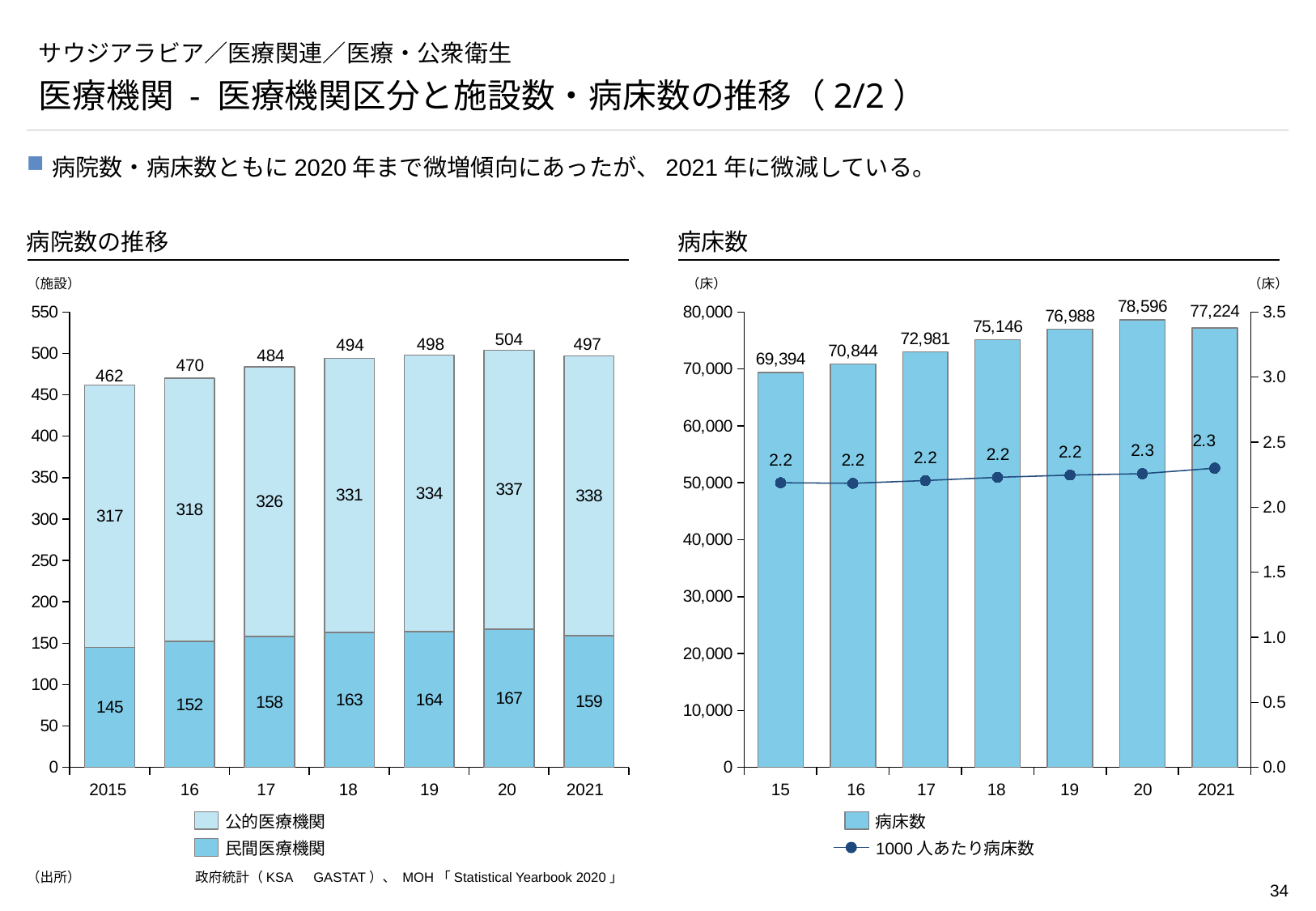
In the 病床数 chart, what is the value for 1000人あたり病床数 in 2021? 2.3 In the 病床数 chart, how many years are shown on the x axis? 7 In the 病床数 chart, which year has the lowest 病床数? 15 In the 病院数の推移 chart, what is the difference between the 民間医療機関 values for 20 and 2021? 8 In the 病院数の推移 chart, how many series does the legend list? 2 In the 病院数の推移 chart, which year has the highest total number of hospitals? 20 In the 病院数の推移 chart, what is the value for 民間医療機関 in 20? 167 In the 病床数 chart, is the 病床数 for 20 larger or smaller than for 2021? larger What kind of chart is the 病院数の推移 chart? stacked bar chart In the 病院数の推移 chart, what is the total of the stacked bar for 2021? 497 In the 病床数 chart, what is the value for 病床数 in 18? 75,146 In the 病院数の推移 chart, what is the value for 公的医療機関 in 2015? 317